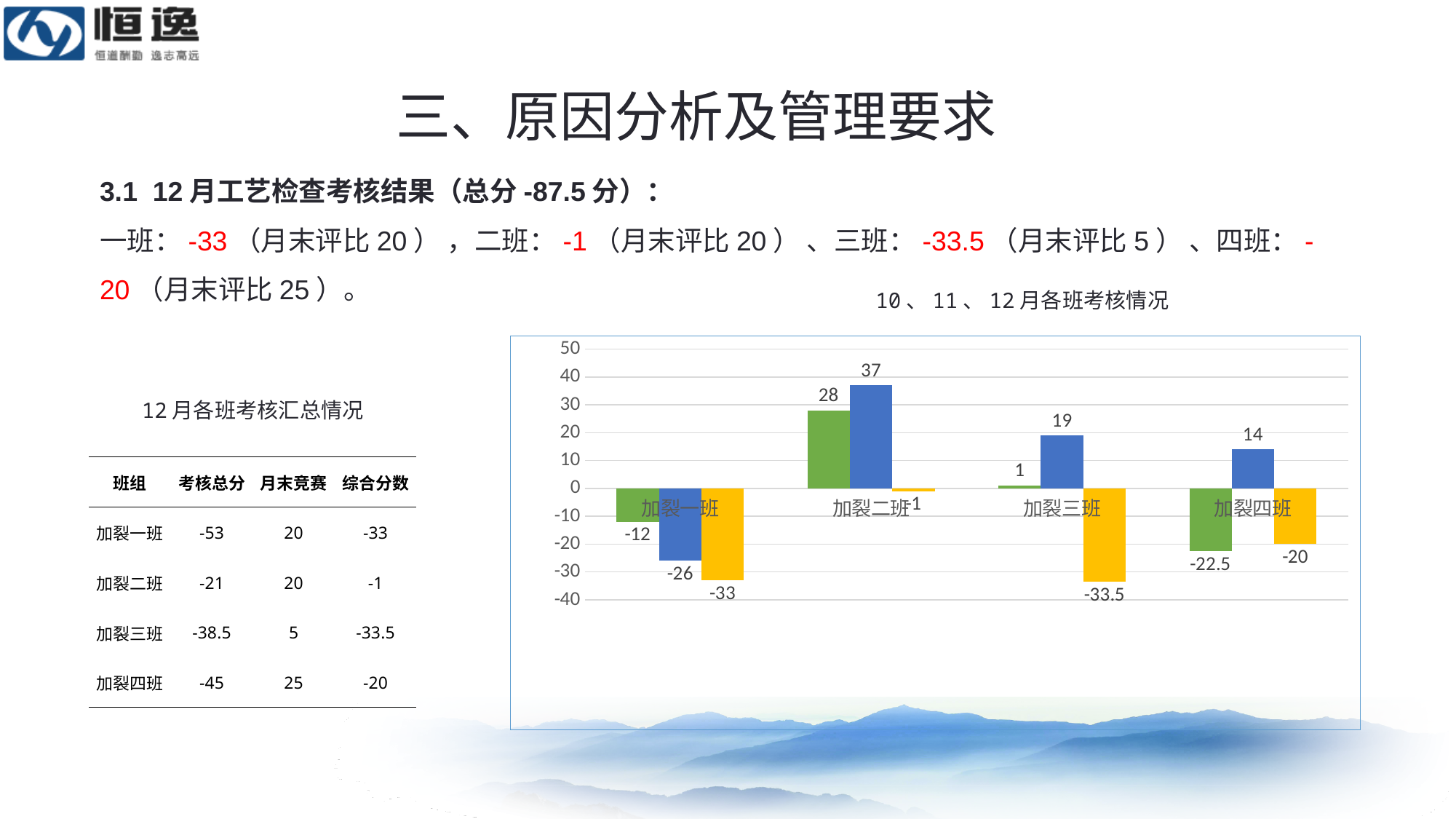
What is the value of the yellow bar for 加裂三班? -33.5 Is the value of the blue bar for 加裂三班 greater or less than 10? greater What is the difference between the blue bar and the green bar for 加裂二班? 9 What is the value of the green bar for 加裂四班? -22.5 Which category has the lowest yellow bar? 加裂三班 What is the title of the chart? 10、11、12月各班考核情况 Which category has the highest blue bar? 加裂二班 What type of chart is shown under the title 10、11、12月各班考核情况? bar chart What is the value of the yellow bar for 加裂二班? -1 What is the value of the blue bar for 加裂二班? 37 How many 班组 categories are shown on the x axis of the chart? 4 Which is larger for 加裂一班, the green bar or the blue bar? green bar